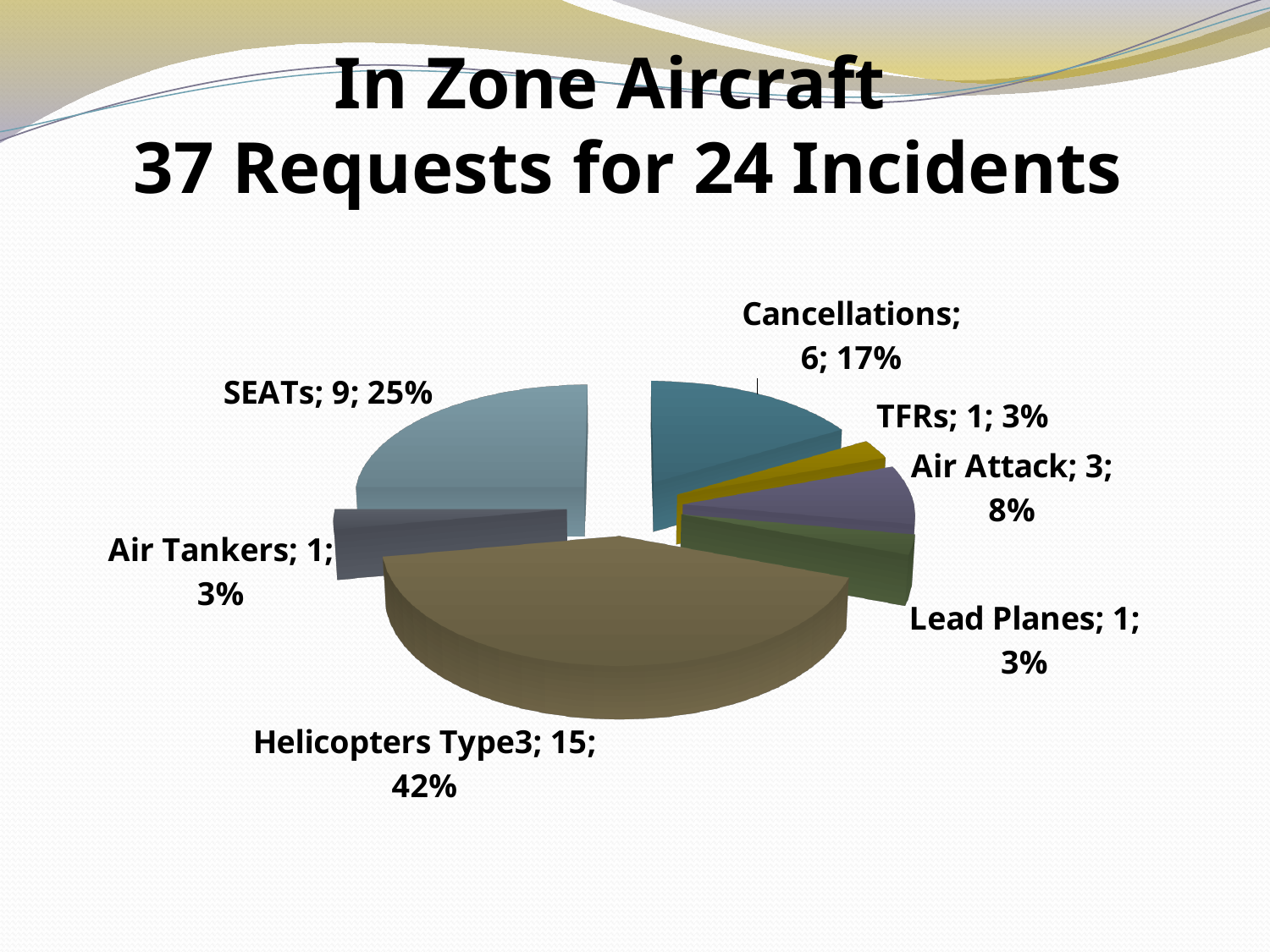
What percentage of the pie is TFRs? 3% What share of the pie does Air Attack represent? 8% How many requests were for Helicopters Type3? 15 How many slices does the pie chart have? 7 Which category has the largest slice of the pie? Helicopters Type3 What kind of chart is shown on the slide? pie chart How many requests were for Lead Planes? 1 What is the difference between the number of requests for Helicopters Type3 and SEATs? 6 How many requests were Cancellations? 6 Which is larger, the number of requests for Cancellations or for Air Attack? Cancellations What is the title of the slide? In Zone Aircraft 37 Requests for 24 Incidents What percentage of the pie is SEATs? 25%